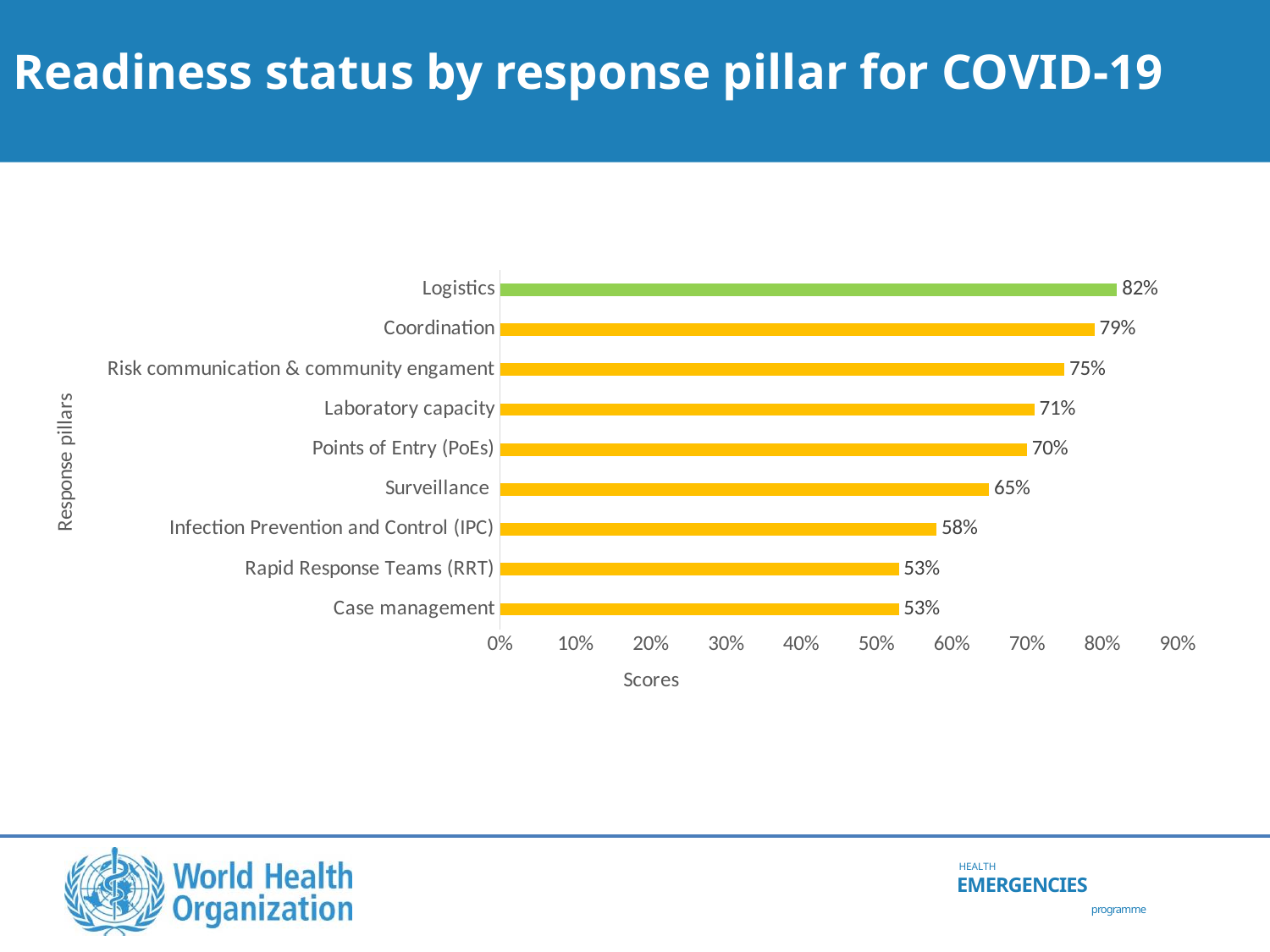
How many response pillars are shown on the chart? 9 Which response pillar has the highest readiness score? Logistics What is the readiness score for Logistics? 82% What is the difference between the readiness scores for Laboratory capacity and Points of Entry (PoEs)? 1% What type of chart is shown on the slide? Bar chart Which has a higher readiness score, Risk communication & community engament or Surveillance? Risk communication & community engament What is the readiness score for Infection Prevention and Control (IPC)? 58% What is the label of the horizontal axis? Scores What is the readiness score for Surveillance? 65% What is the lowest readiness score shown on the chart? 53% Is the readiness score for Rapid Response Teams (RRT) greater or less than 60%? less What is the difference between the readiness scores for Coordination and Case management? 26%